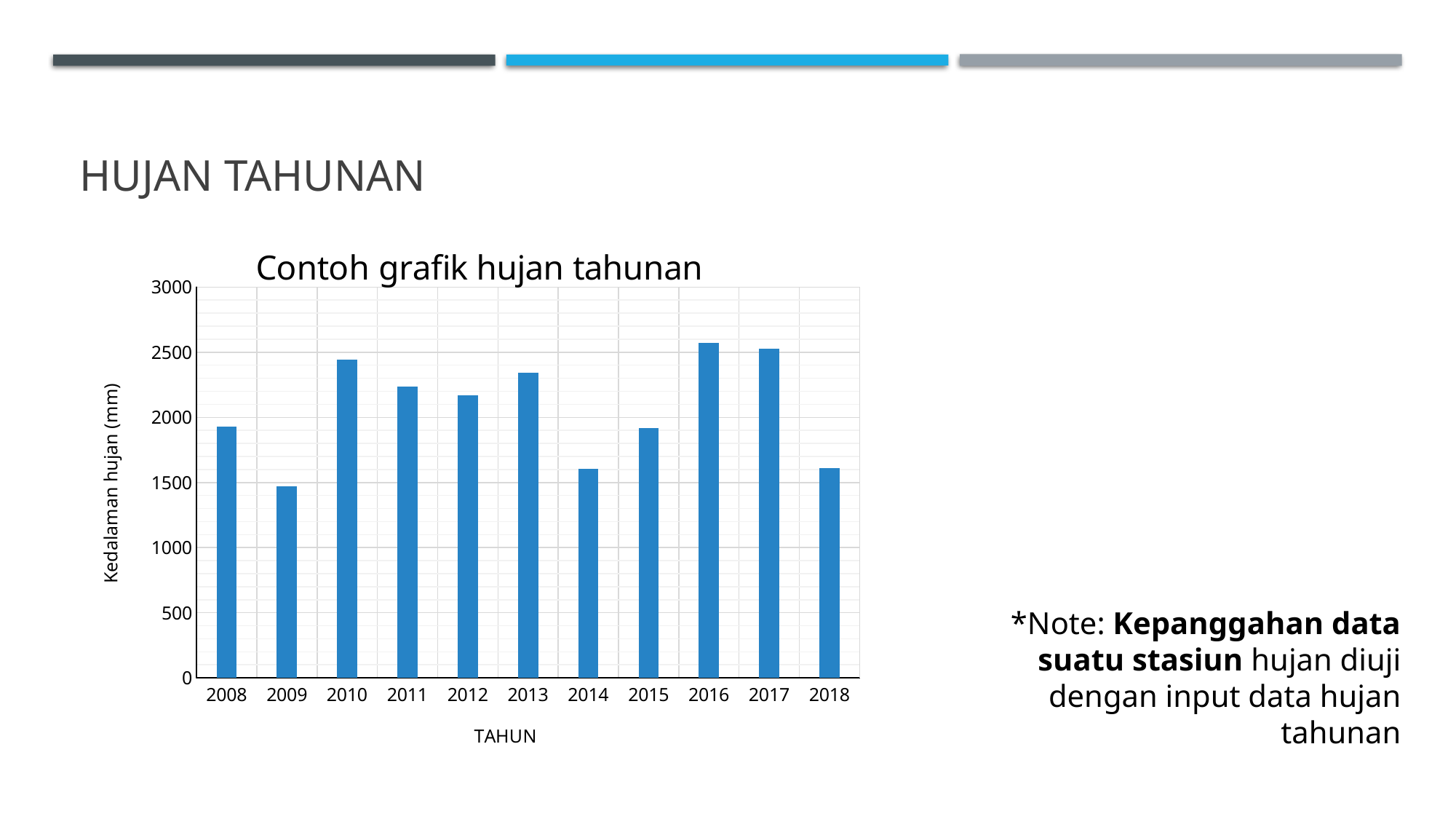
Which year has the lowest rainfall depth in the chart? 2009 How many years are plotted on the x axis of the chart? 11 Do the values rise or fall from 2016 to 2018? fall Is the value for 2014 greater or less than 1500? greater Is the value for 2008 greater or less than 2000? less Is the value for 2010 greater or less than 2000? greater Which year has the larger value, 2012 or 2013? 2013 What is the title of the chart? Contoh grafik hujan tahunan What kind of chart is shown on the slide? bar chart Which year has the larger value, 2010 or 2011? 2010